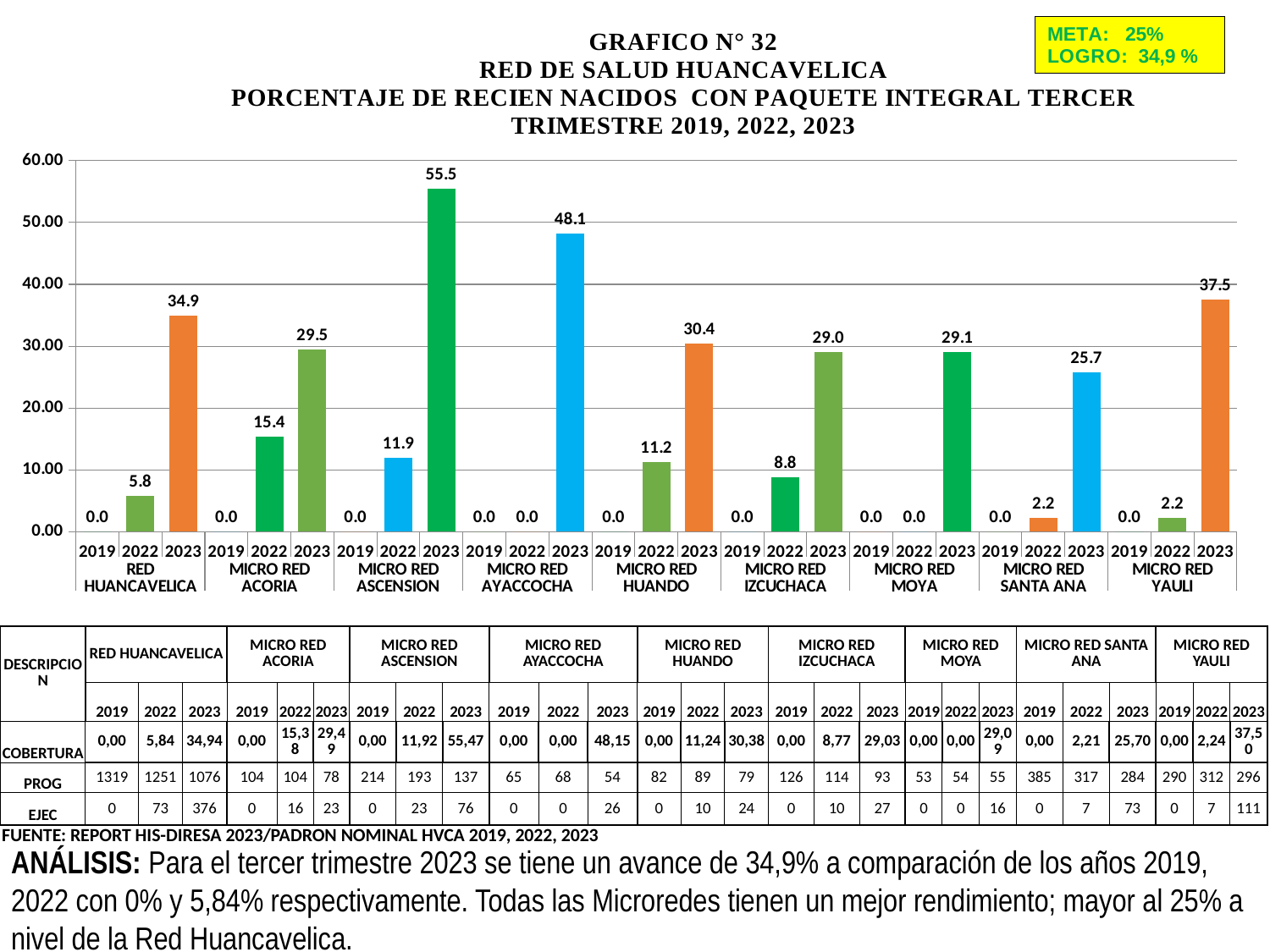
Is the 2023 value for MICRO RED AYACCOCHA greater or less than 40.00? greater What kind of chart is shown on the slide? bar chart Which group has the lowest 2023 value? MICRO RED SANTA ANA How many micro red / red groups are shown on the x axis? 9 What is the value for MICRO RED ASCENSION in 2023? 55.5 What is the number of the graphic shown in the chart title? GRAFICO N° 32 Which is larger, the 2023 value for MICRO RED HUANDO or the 2023 value for MICRO RED IZCUCHACA? MICRO RED HUANDO Which group has the highest 2023 value? MICRO RED ASCENSION What is the value for MICRO RED YAULI in 2023? 37.5 What is the value for RED HUANCAVELICA in 2022? 5.8 What is the difference between the 2023 and 2022 values for MICRO RED ACORIA? 14.1 Do the values for MICRO RED MOYA rise or fall from 2019 to 2023? rise